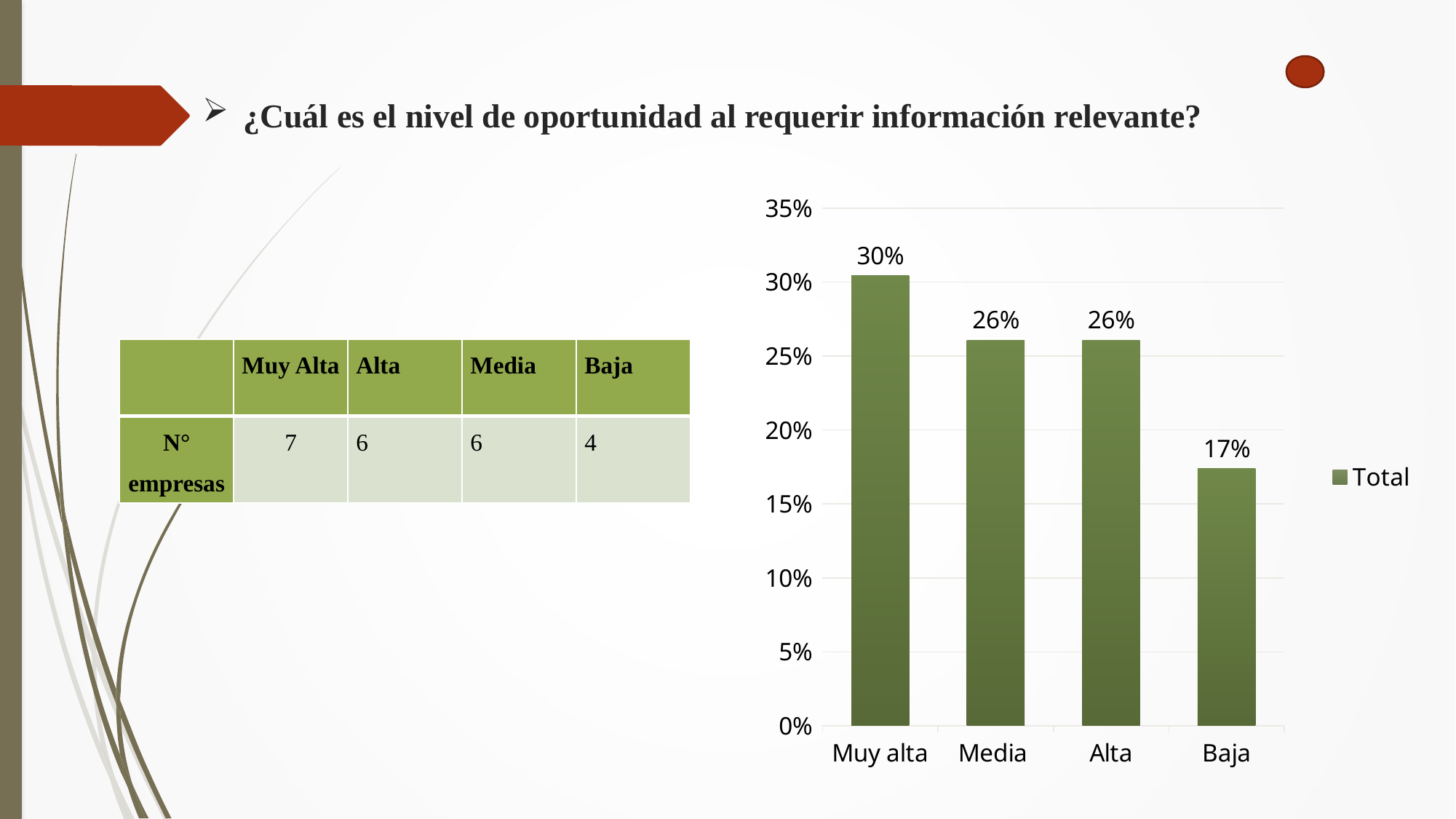
Is the value for Baja greater or less than 20%? less How many categories are shown on the x axis of the chart? 4 What is the difference between the values for Muy alta and Alta? 4% What is the value for Media in the chart? 26% What is the value for Baja in the chart? 17% How many series does the chart legend list? 1 Which category has the highest value in the chart? Muy alta Which category has the lowest value in the chart? Baja What kind of chart is shown on the slide? bar chart Which is larger, the value for Alta or the value for Baja? Alta What is the value for Muy alta in the chart? 30% What is the difference between the values for Muy alta and Baja? 13%